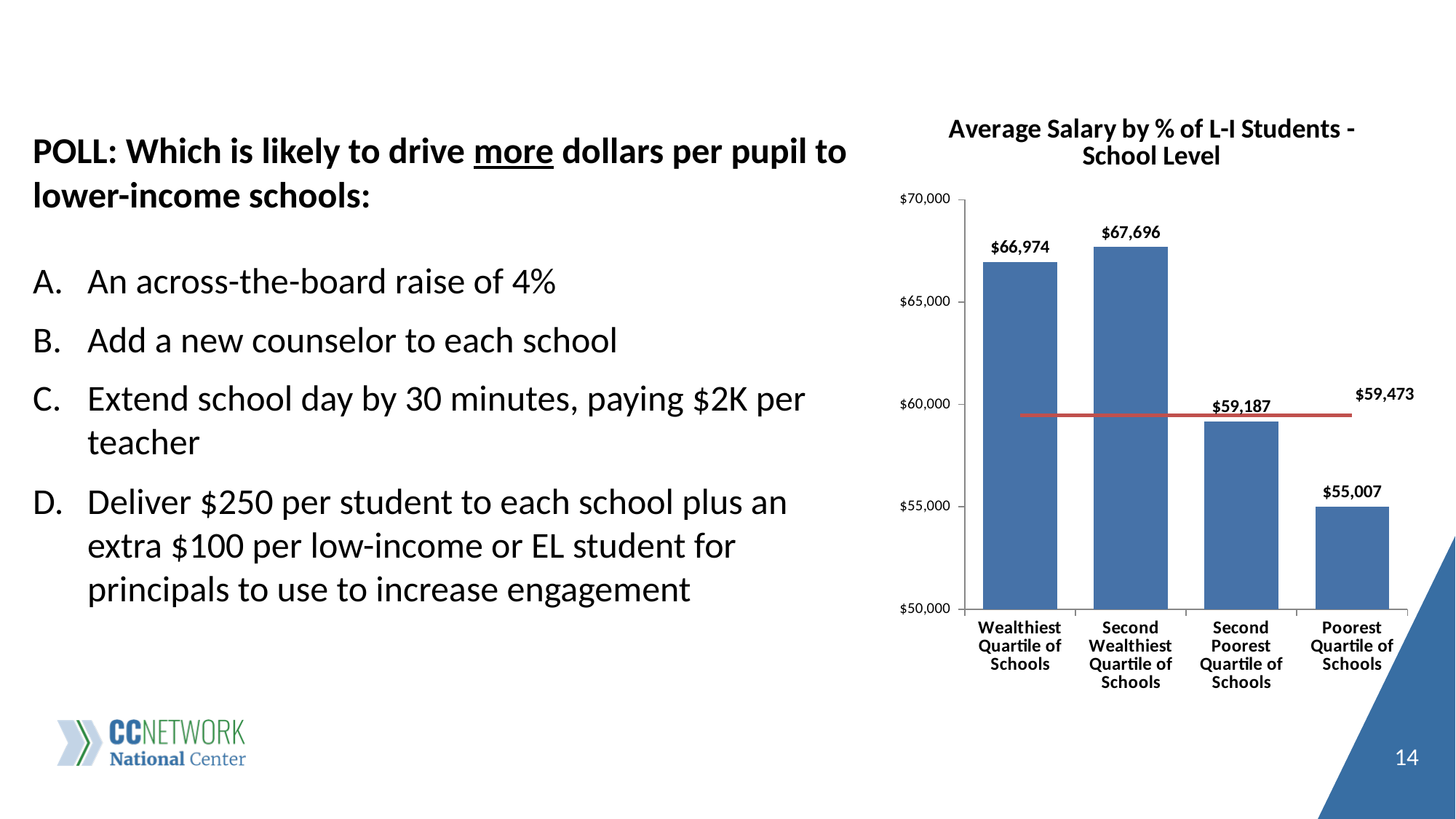
What is the difference in average salary between the Wealthiest Quartile of Schools and the Second Poorest Quartile of Schools? $7,787 Which quartile of schools has the lowest average salary? Poorest Quartile of Schools What is the average salary for the Second Wealthiest Quartile of Schools? $67,696 Which quartile of schools has the highest average salary? Second Wealthiest Quartile of Schools Which has a higher average salary, the Second Poorest Quartile of Schools or the Poorest Quartile of Schools? Second Poorest Quartile of Schools What is the average salary for the Second Poorest Quartile of Schools? $59,187 What is the average salary for the Wealthiest Quartile of Schools? $66,974 What is the difference in average salary between the Second Wealthiest Quartile of Schools and the Poorest Quartile of Schools? $12,689 What is the average salary for the Poorest Quartile of Schools? $55,007 What value is labelled on the red horizontal line in the chart? $59,473 How many quartile categories are shown on the x axis of the chart? 4 What kind of chart is shown on the slide? Bar chart